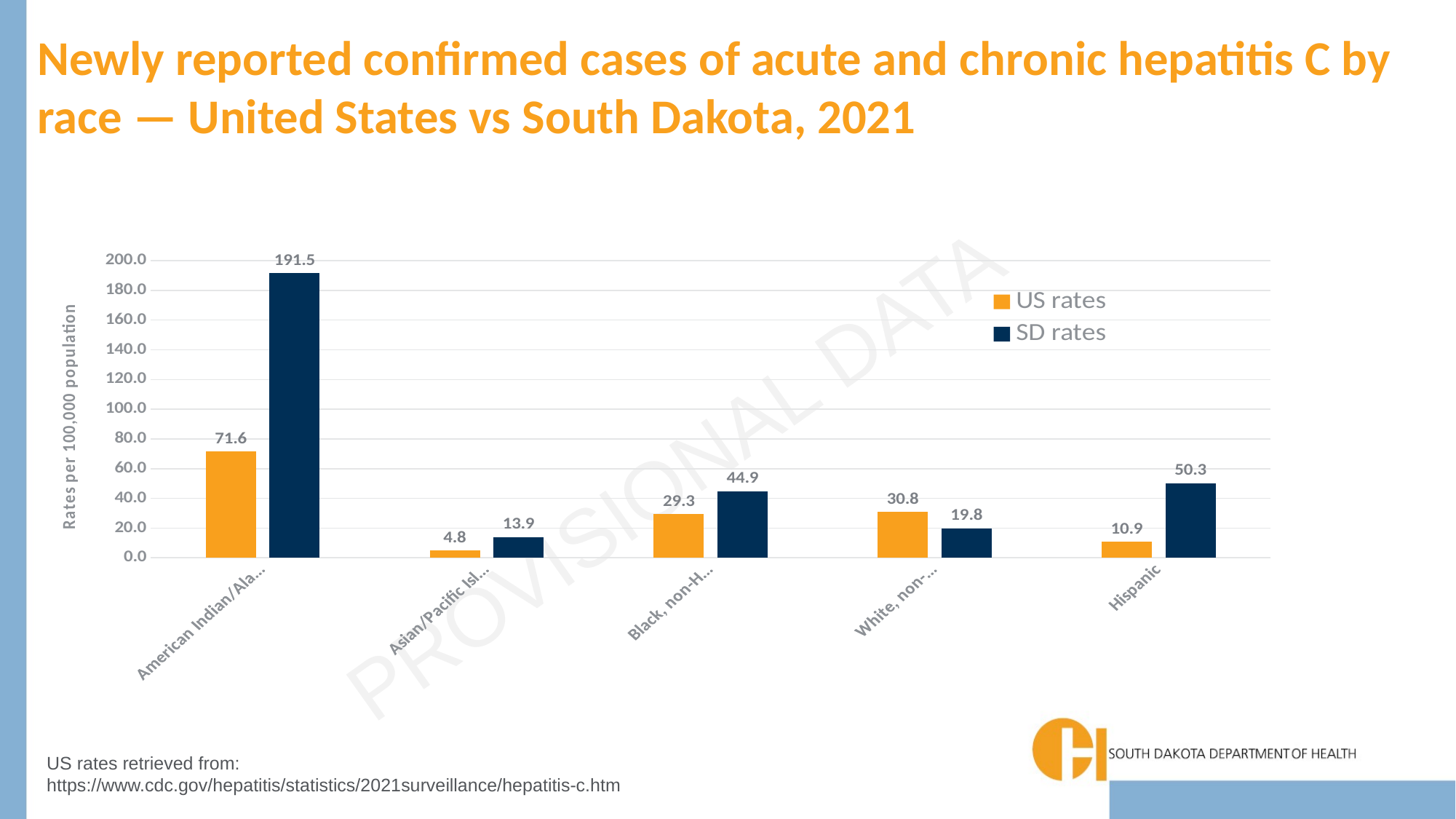
What is the difference between the SD rate and the US rate for the American Indian category? 119.9 What kind of chart is shown on the slide? Bar chart Which category has the lowest US rate? Asian/Pacific Islander How many series does the legend list? 2 How many race categories are shown on the x axis? 5 What is the US rate for the Asian/Pacific Islander category? 4.8 What is the SD rate for the Black, non-Hispanic category? 44.9 What is the difference between the SD rate and the US rate for Hispanic? 39.4 Which category has the highest SD rate? American Indian/Alaska Native What is the SD rate for the American Indian category? 191.5 What is the US rate for Hispanic? 10.9 For the White, non-Hispanic category, which is larger: the US rate or the SD rate? US rate